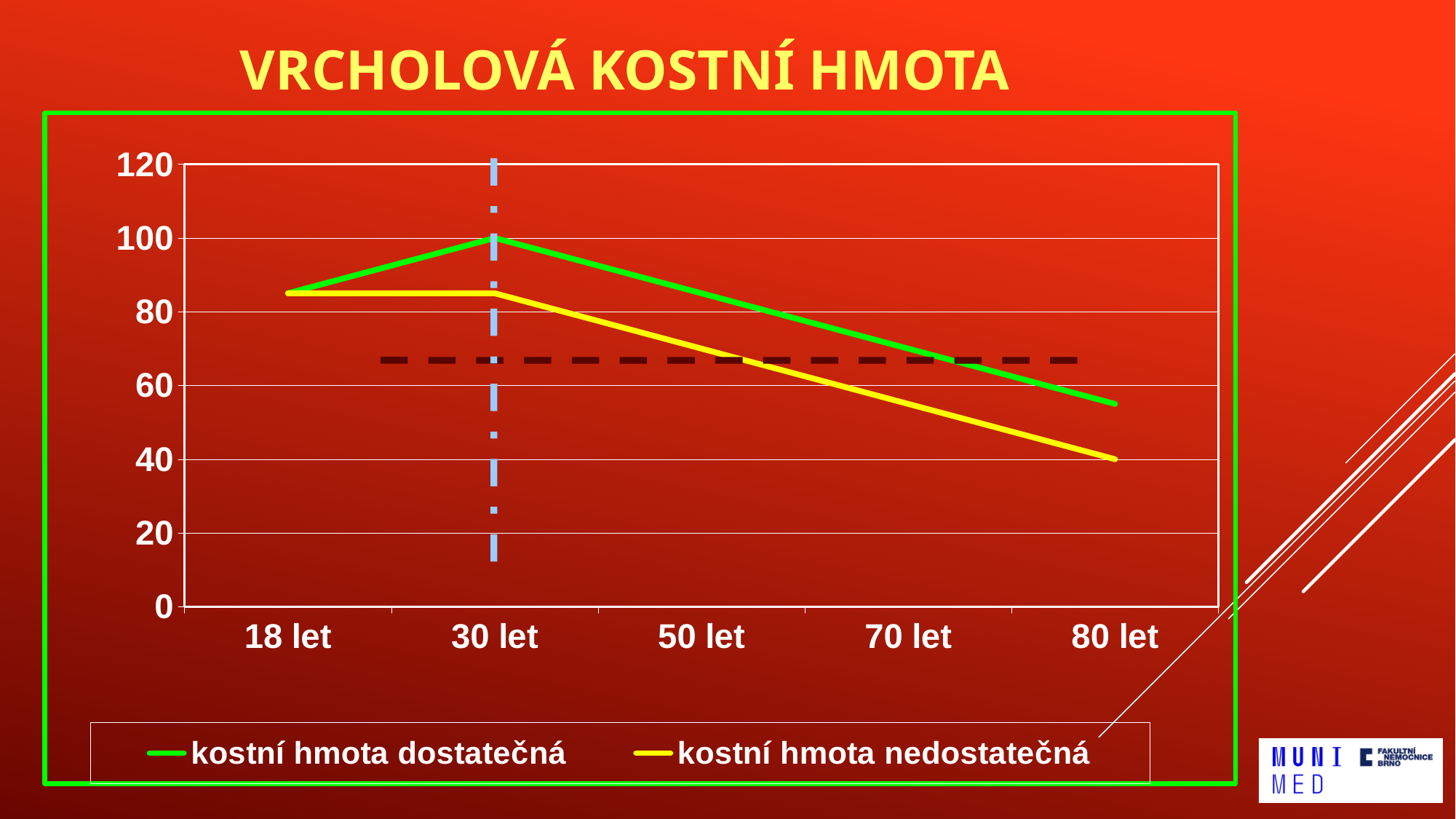
What is the value of the 'kostní hmota nedostatečná' series at 80 let? 40 What kind of chart is shown on the slide? line chart At which age does the 'kostní hmota dostatečná' series reach its highest value? 30 let Does the 'kostní hmota dostatečná' series rise or fall from 30 let to 80 let? fall What is the value of the 'kostní hmota dostatečná' series at 30 let? 100 How many age categories are shown on the x axis? 5 Is the value of 'kostní hmota dostatečná' at 80 let greater or less than 60? less At 80 let, which series has the higher value? kostní hmota dostatečná How many series does the legend list? 2 Is the value of 'kostní hmota nedostatečná' at 18 let greater or less than 80? greater Which colour represents the 'kostní hmota nedostatečná' series? yellow What is the title of the slide? VRCHOLOVÁ KOSTNÍ HMOTA